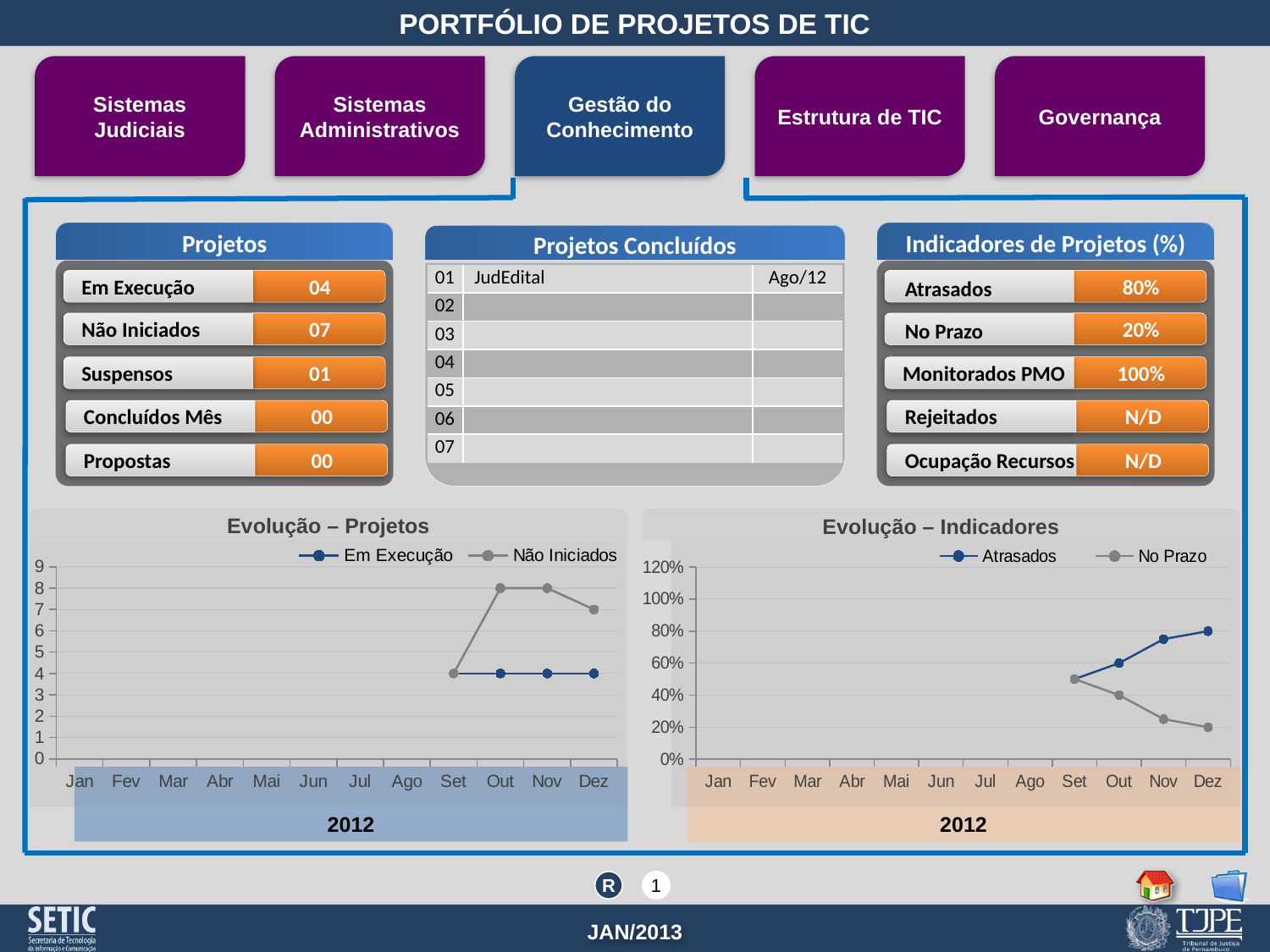
In the "Evolução – Indicadores" chart, what is the value of Atrasados in Dez? 80% Which series in the "Evolução – Indicadores" chart is drawn in blue? Atrasados In the "Evolução – Indicadores" chart, is the value of Atrasados in Nov greater or less than 60%? greater In the "Evolução – Projetos" chart, what is the value of Não Iniciados in Out? 8 In the "Evolução – Indicadores" chart, does the Atrasados series rise or fall from Set to Dez? rise In the "Evolução – Indicadores" chart, what is the value of No Prazo in Out? 40% In the "Evolução – Projetos" chart, what is the difference between Não Iniciados and Em Execução in Nov? 4 What type of chart is the "Evolução – Projetos" chart? line chart How many series does the legend of the "Evolução – Projetos" chart list? 2 In the "Evolução – Projetos" chart, which series is higher in Out, Em Execução or Não Iniciados? Não Iniciados In the "Evolução – Projetos" chart, what is the value of Não Iniciados in Dez? 7 In the "Evolução – Projetos" chart, what is the value of Em Execução in Dez? 4